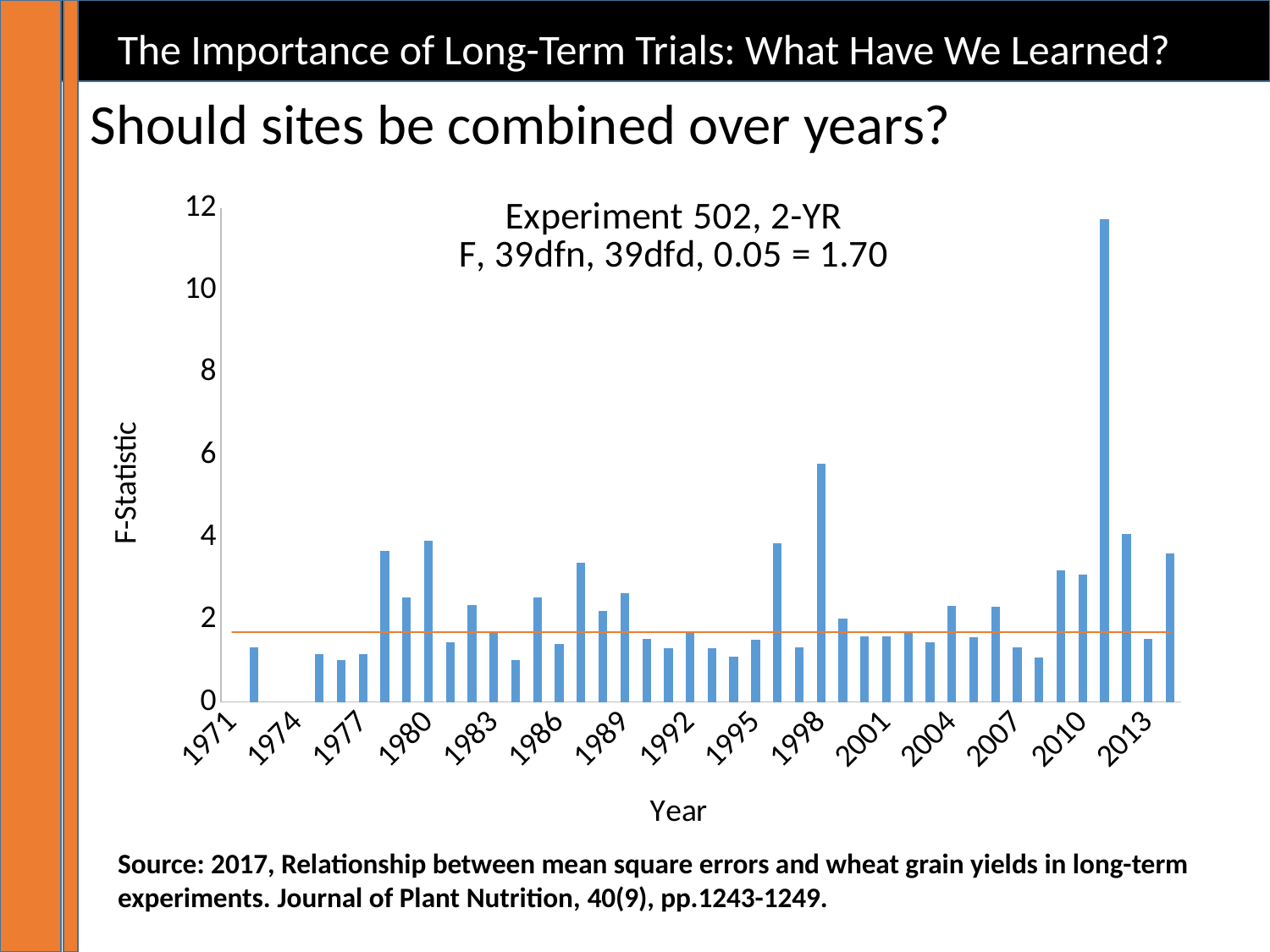
Is the F-statistic for 1980 greater or less than 2? greater Which year has the larger F-statistic, 1998 or 1980? 1998 Is the F-statistic for 1998 greater or less than 4? greater Is the F-statistic for 2007 greater or less than 2? less What is the title of the chart? Experiment 502, 2-YR F, 39dfn, 39dfd, 0.05 = 1.70 Which year has the larger F-statistic, 1980 or 1977? 1980 What is the label of the vertical axis? F-Statistic What kind of chart is shown on the slide? Bar chart